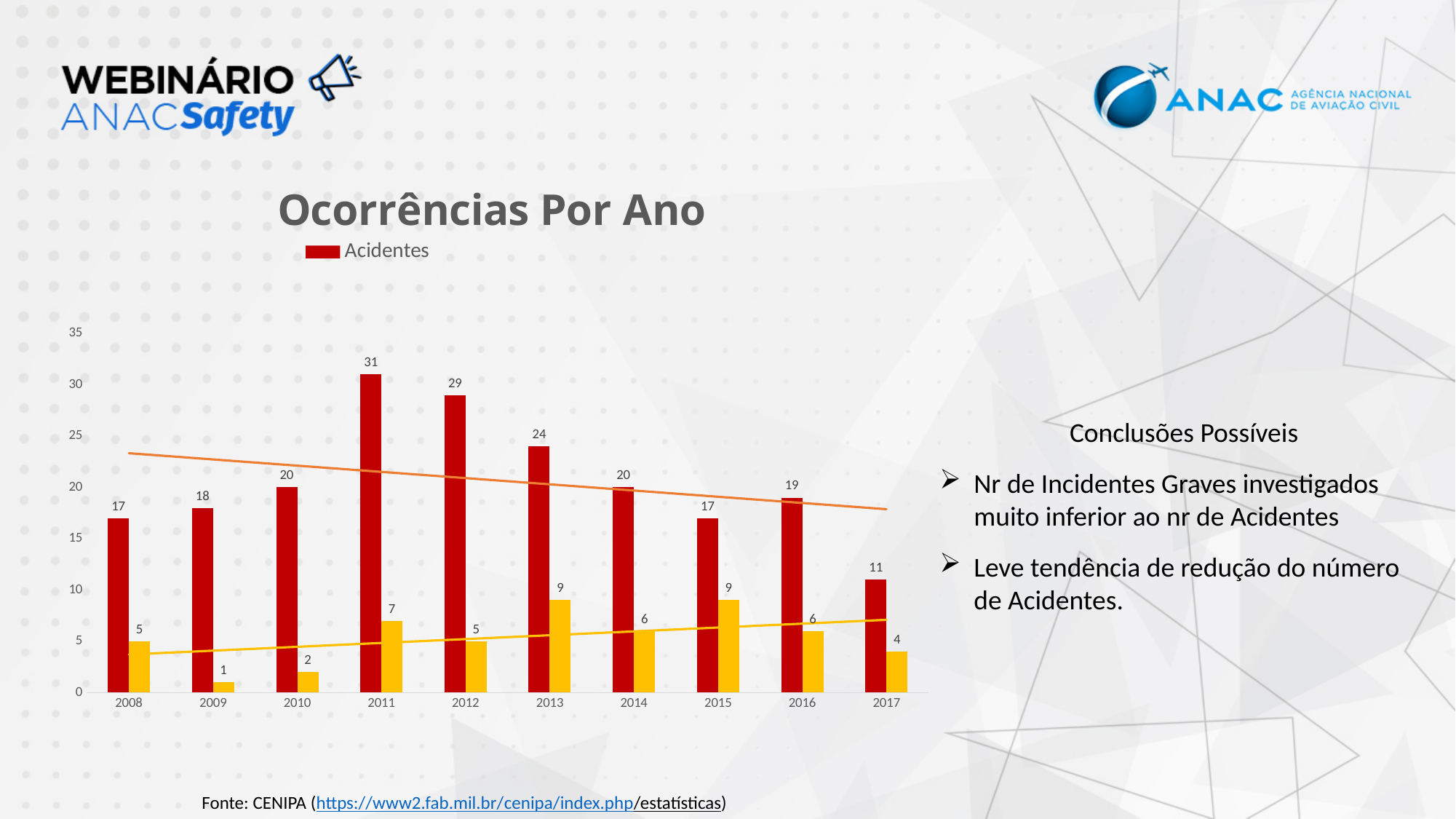
Which is larger, Acidentes in 2010 or Acidentes in 2016? 2010 What type of chart is shown on the slide? bar chart How many years are shown on the x axis? 10 Which year has the highest number of Acidentes? 2011 How many series does the legend list? 1 Which year has the lowest number of Acidentes? 2017 What is the value of Acidentes for 2011? 31 What is the value of the yellow bar for 2013? 9 What is the value of Acidentes for 2017? 11 What is the difference between Acidentes in 2011 and Acidentes in 2012? 2 What is the difference between the red bar and the yellow bar in 2008? 12 Which year has the lowest value for the yellow bars? 2009